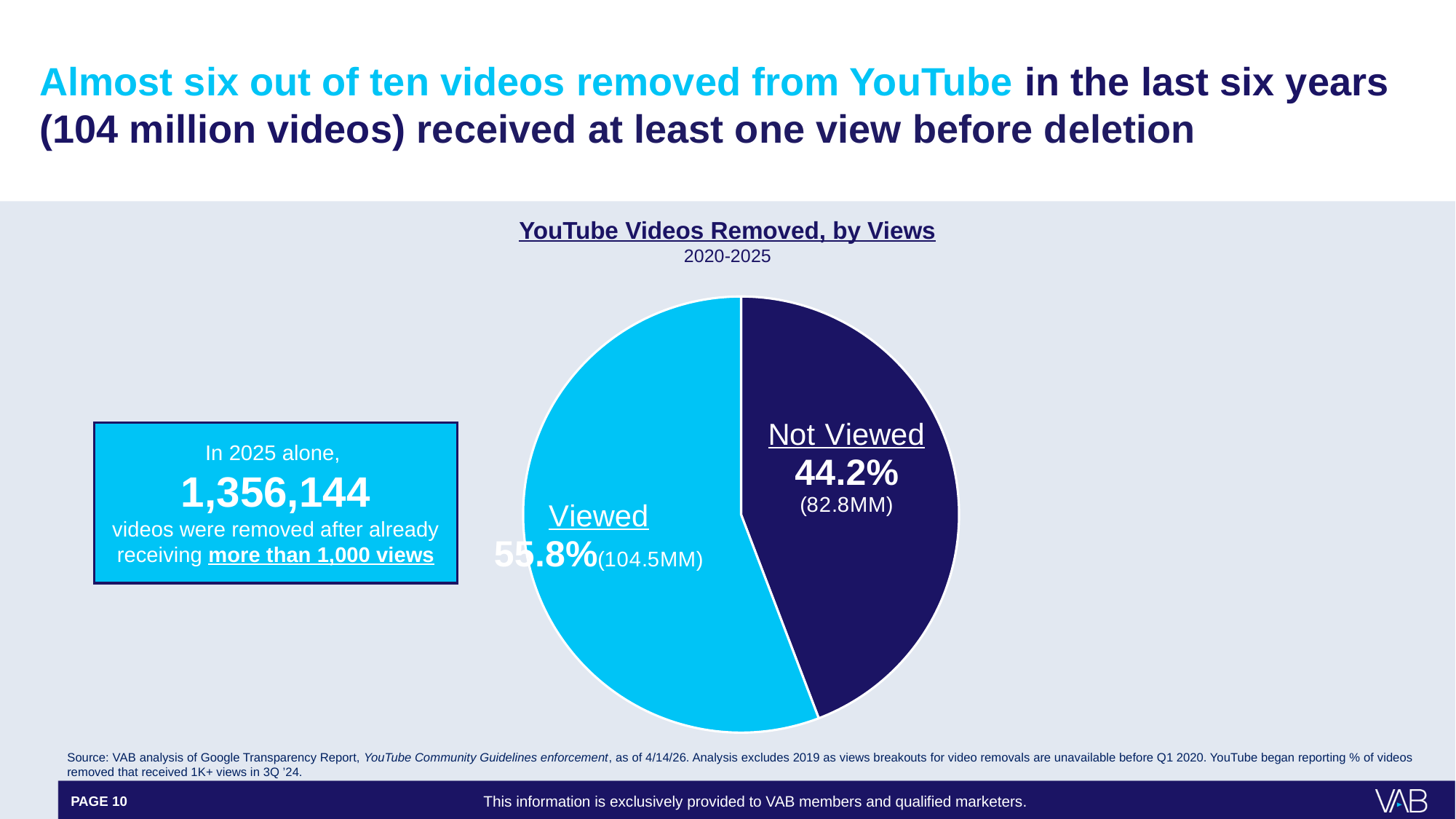
What kind of chart is shown on the slide? Pie chart What is the difference in percentage points between the Viewed and Not Viewed slices? 11.6 How many videos (in MM) does the Not Viewed slice represent? 82.8MM What share of removed videos were Not Viewed? 44.2% Which is larger, the Viewed slice or the Not Viewed slice? Viewed Which slice of the pie is the largest? Viewed How many slices does the pie chart have? 2 Which slice of the pie is the smallest? Not Viewed How many videos (in MM) does the Viewed slice represent? 104.5MM What share of removed videos were Viewed? 55.8% What is the title of the chart? YouTube Videos Removed, by Views What time period does the chart subtitle cover? 2020-2025